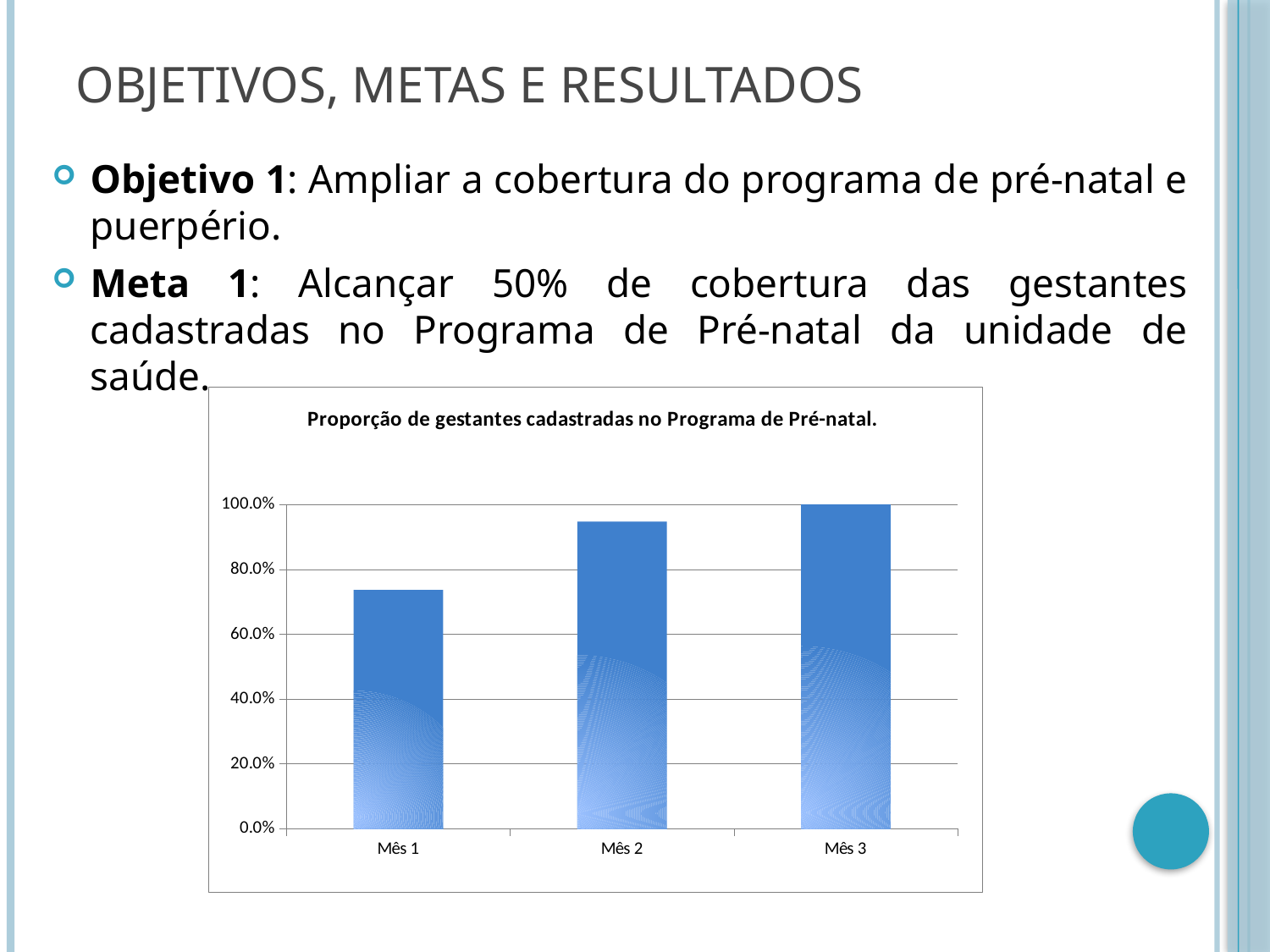
What kind of chart is shown on the slide? Bar chart What is the value for Mês 3? 100.0% Is the value for Mês 1 greater or less than 60.0%? greater Which month has the lowest proportion of registered pregnant women? Mês 1 How many categories (months) are plotted in the chart? 3 Is the value for Mês 2 greater or less than 80.0%? greater What is the highest value shown on the vertical axis? 100.0% Which month has the highest proportion of registered pregnant women? Mês 3 What is the title of the chart? Proporção de gestantes cadastradas no Programa de Pré-natal. Do the values rise or fall from Mês 1 to Mês 3? Rise Which is larger, the value for Mês 1 or the value for Mês 2? Mês 2 Is the value for Mês 1 greater or less than 80.0%? less